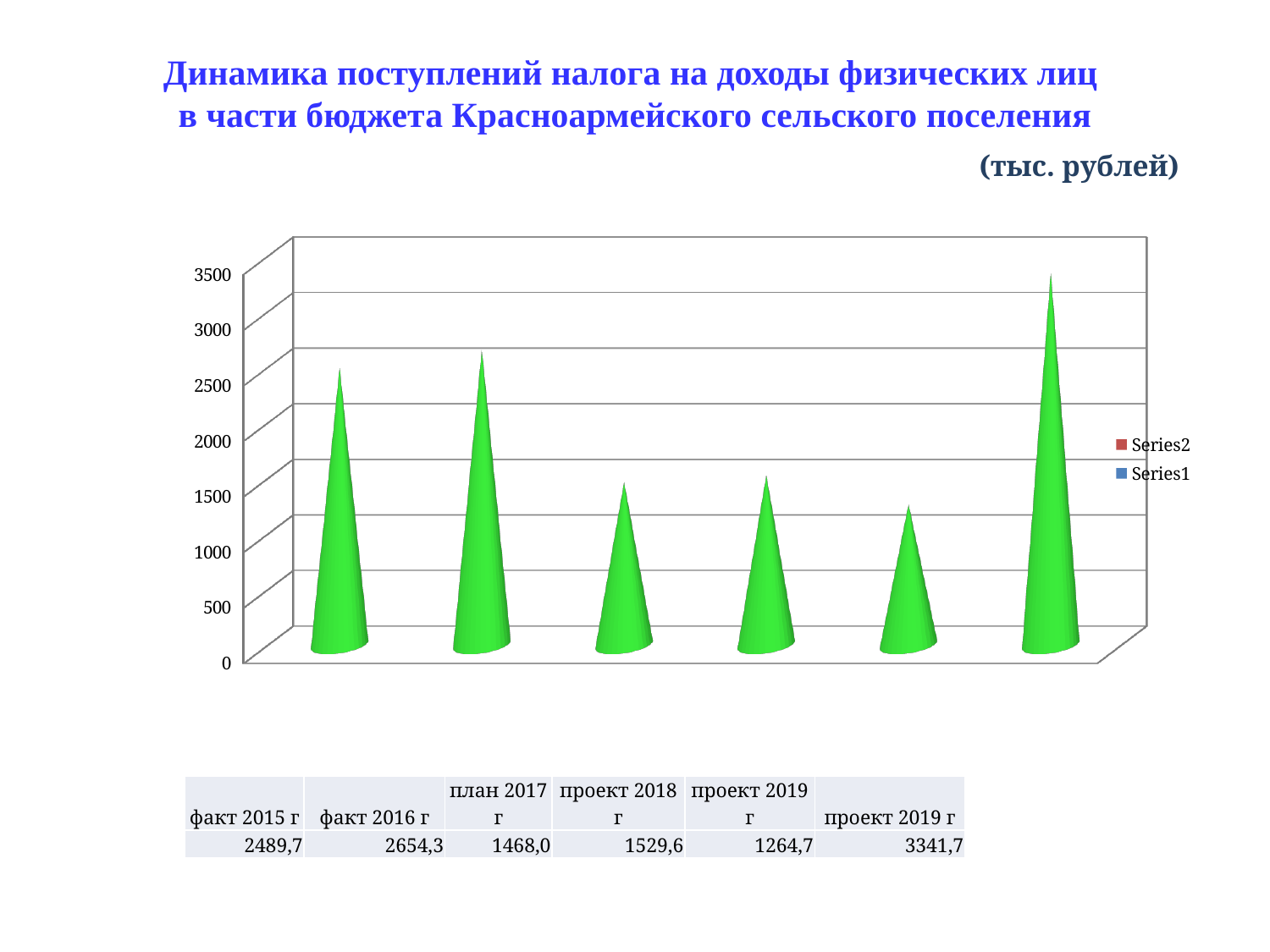
What is the value for план 2017 г? 1468,0 Is the value for факт 2015 г greater or less than 2000? greater What is the value for факт 2016 г? 2654,3 How many series does the legend list? 2 What is the difference between the values for факт 2016 г and факт 2015 г? 164,6 What kind of chart is shown on the slide? bar chart Which is larger, the value for план 2017 г or the value for проект 2018 г? проект 2018 г What is the value for проект 2018 г? 1529,6 How many categories are plotted in the chart? 6 What is the value for факт 2015 г? 2489,7 What is the lowest value shown in the chart? 1264,7 What is the highest value shown in the chart? 3341,7